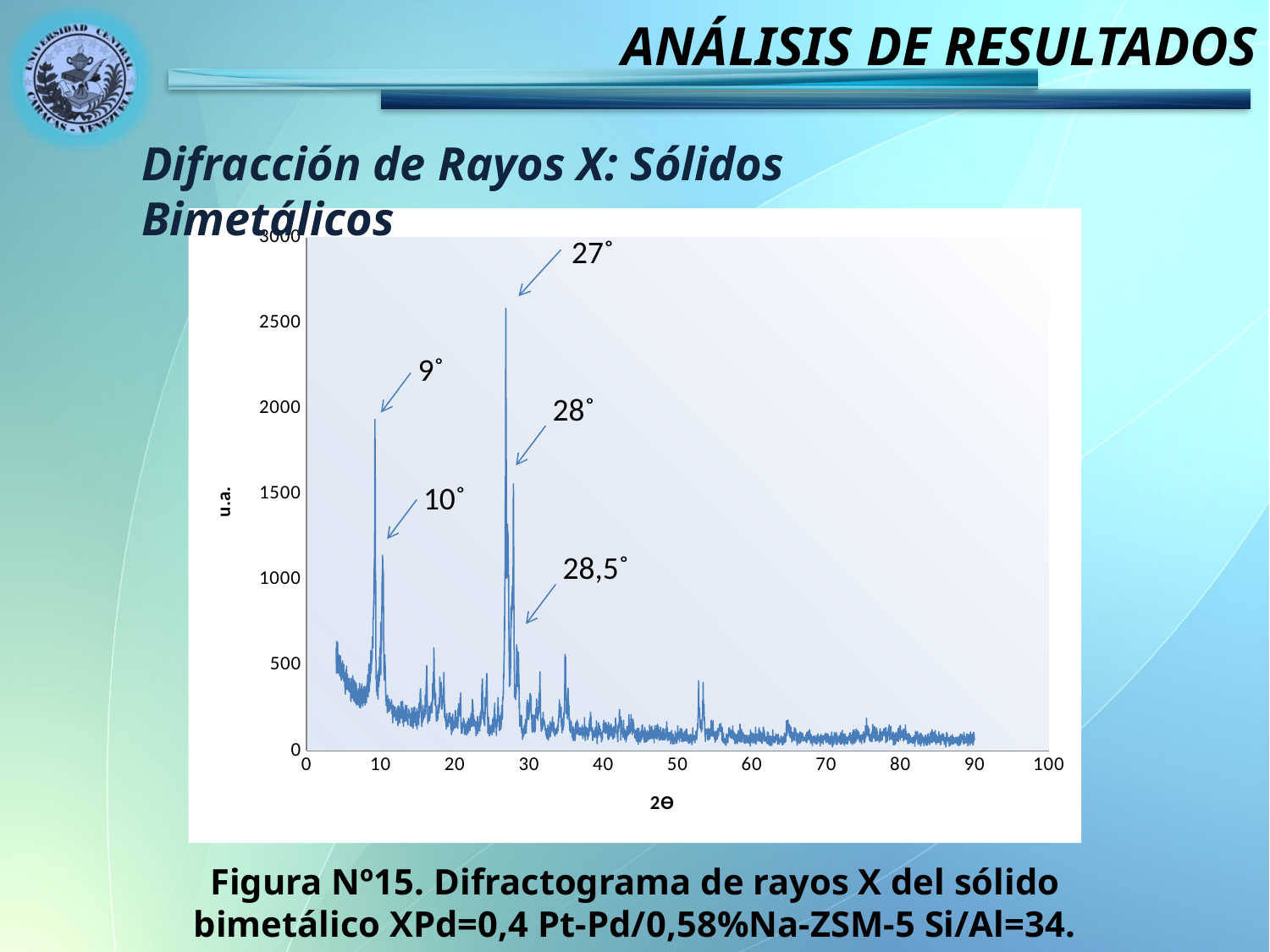
Is the intensity of the peak at 28° greater or less than 1000? greater Is the intensity of the peak at 9° greater or less than 1500? greater Does the baseline intensity generally rise or fall as 2Θ increases from 30 to 90? fall How many peaks are annotated with angle labels on the chart? 5 What is the label of the x axis of the chart? 2Θ Which annotated peak has the highest intensity? 27° Is the intensity of the peak at 27° greater or less than 2000? greater Which annotated peak has the lowest intensity? 28,5° Which peak has a higher intensity, the one at 9° or the one at 28°? 9° What is the label of the y axis of the chart? u.a. What kind of chart is shown on the slide? line chart